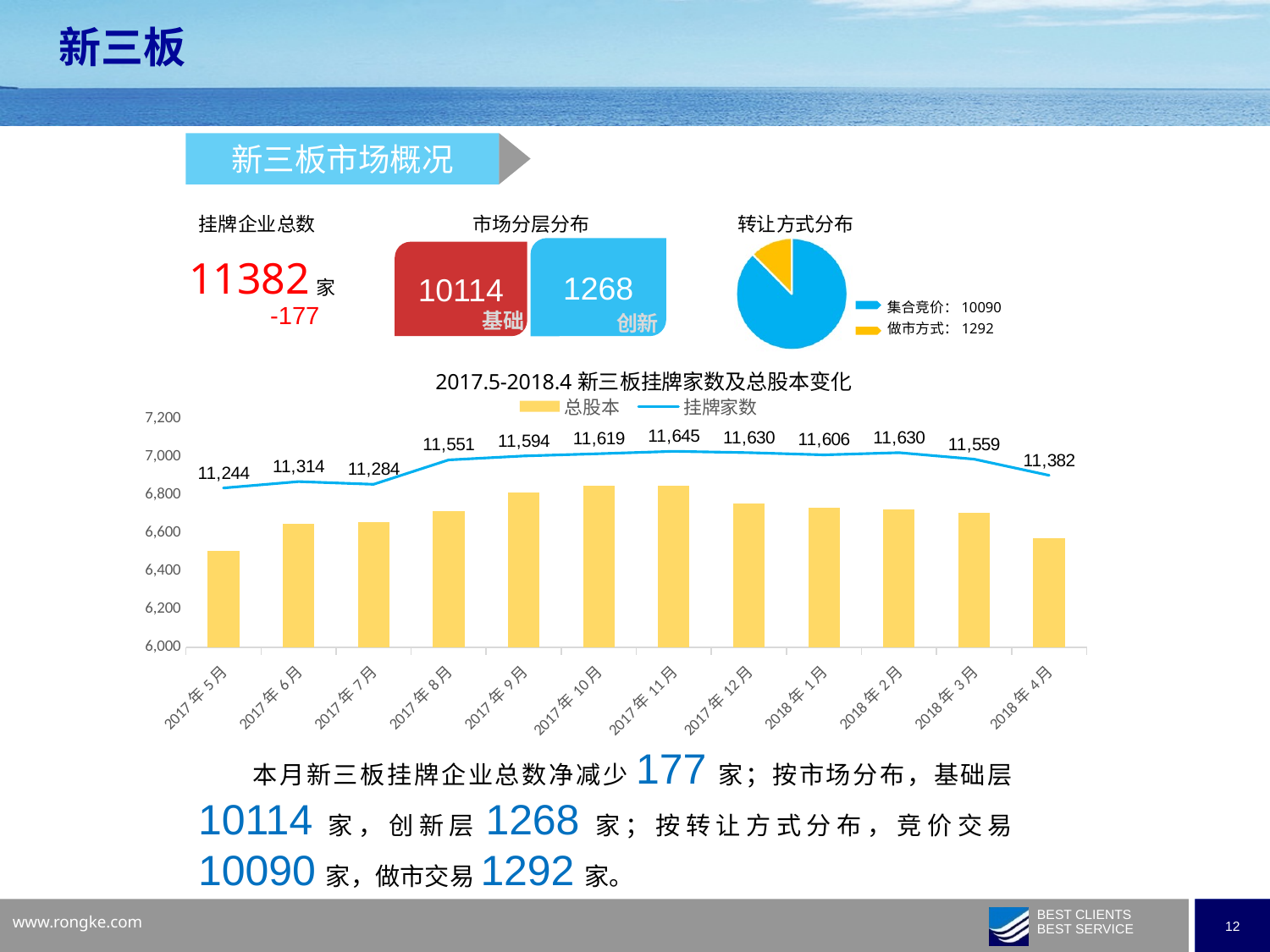
In the chart titled 2017.5-2018.4 新三板挂牌家数及总股本变化, which month has the highest 挂牌家数? 2017年11月 In the chart titled 2017.5-2018.4 新三板挂牌家数及总股本变化, what is the 挂牌家数 value for 2018年4月? 11,382 In the chart titled 2017.5-2018.4 新三板挂牌家数及总股本变化, how many months are shown on the x axis? 12 In the chart titled 2017.5-2018.4 新三板挂牌家数及总股本变化, is the 总股本 bar for 2017年11月 greater or less than 6,800? greater In the chart titled 2017.5-2018.4 新三板挂牌家数及总股本变化, what is the 挂牌家数 value for 2017年11月? 11,645 In the chart titled 2017.5-2018.4 新三板挂牌家数及总股本变化, is the 总股本 bar for 2017年5月 greater or less than 6,600? less In the chart titled 2017.5-2018.4 新三板挂牌家数及总股本变化, is the 挂牌家数 higher in 2017年6月 or 2017年7月? 2017年6月 In the pie chart titled 转让方式分布, what is the value for 做市方式? 1292 In the chart titled 2017.5-2018.4 新三板挂牌家数及总股本变化, what is the difference in 挂牌家数 between 2017年11月 and 2018年4月? 263 In the chart titled 2017.5-2018.4 新三板挂牌家数及总股本变化, how many series does the legend list? 2 In the pie chart titled 转让方式分布, which category is larger, 集合竞价 or 做市方式? 集合竞价 In the chart titled 2017.5-2018.4 新三板挂牌家数及总股本变化, which month has the lowest 挂牌家数? 2017年5月